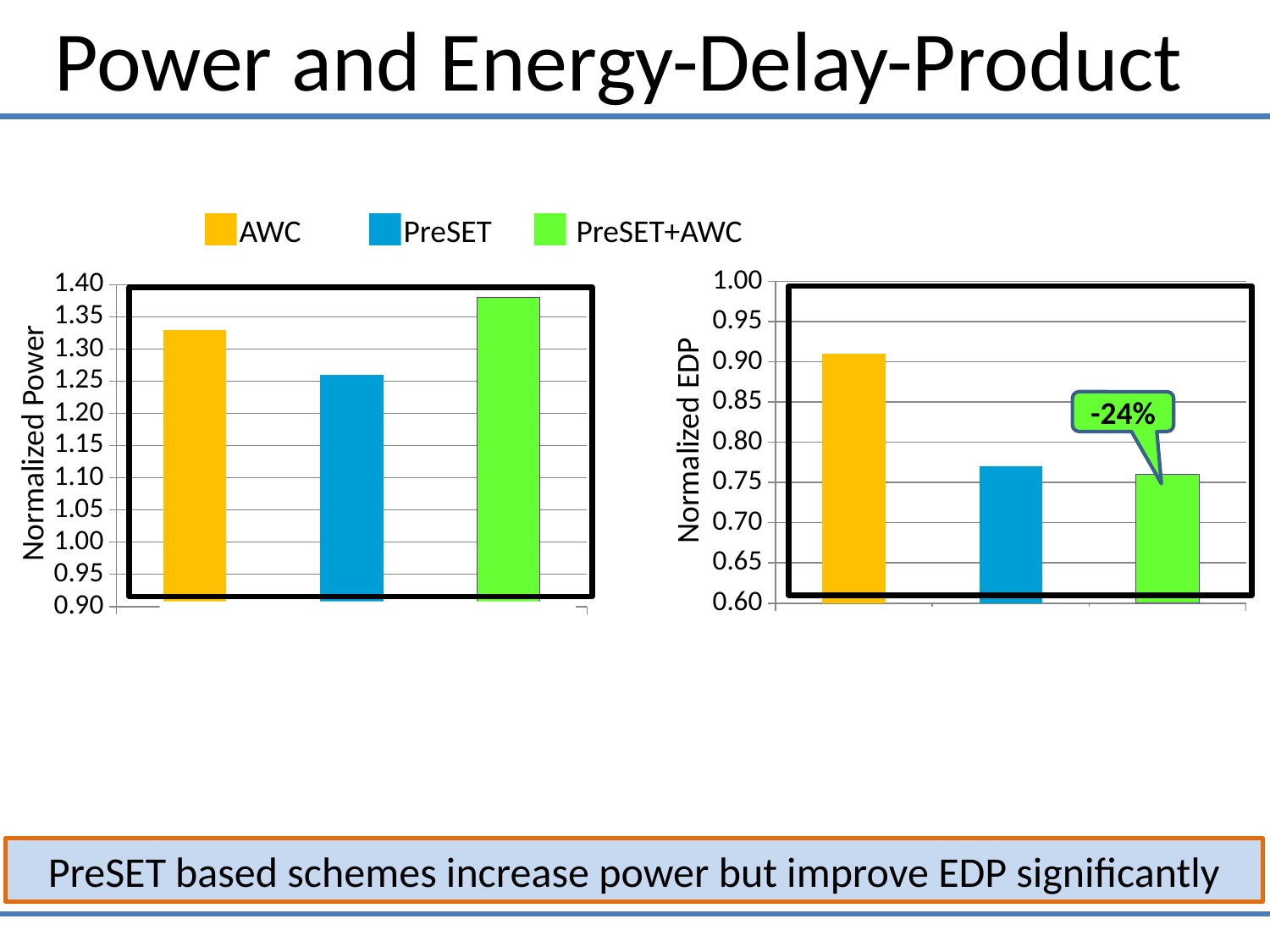
In the Normalized Power chart on the left, is the value for PreSET+AWC greater or less than 1.35? greater In the Normalized EDP chart on the right, which series has the highest bar? AWC In the Normalized Power chart on the left, which series has the lowest bar? PreSET In the Normalized Power chart on the left, is the value for PreSET greater or less than 1.30? less In the Normalized EDP chart on the right, is the value for PreSET greater or less than 0.80? less How many series does the legend list? 3 In the Normalized EDP chart on the right, which is larger, the value for AWC or the value for PreSET+AWC? AWC How many bars are plotted in the Normalized Power chart on the left? 3 In the Normalized Power chart on the left, which series has the highest bar? PreSET+AWC In the Normalized EDP chart on the right, what percentage change does the callout on the PreSET+AWC bar show? -24% What kind of chart is the Normalized Power chart on the left? bar chart